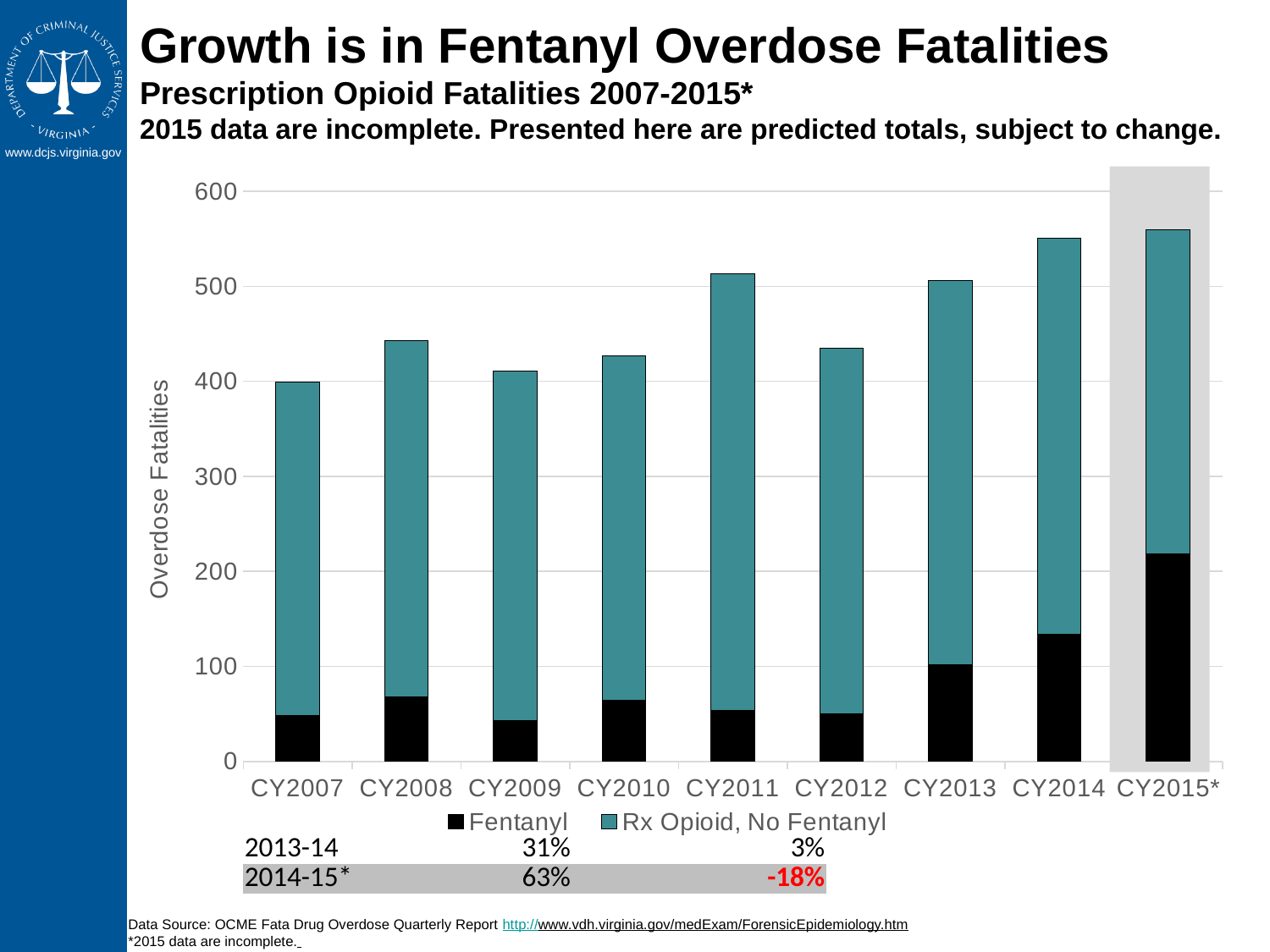
Is the Fentanyl value for CY2014 greater or less than 100? greater Which year has the highest Fentanyl value in the chart? CY2015* Which stacked bar is taller in total, CY2011 or CY2012? CY2011 How many series does the chart's legend list? 2 Is the total height of the stacked bar for CY2011 greater or less than 500? greater What are the two series named in the chart's legend? Fentanyl; Rx Opioid, No Fentanyl Is the Fentanyl value for CY2015* greater or less than 200? greater Does the Fentanyl value rise or fall from CY2012 to CY2015*? rise What kind of chart is shown on the slide? stacked bar chart How many years (categories) are shown on the x axis of the chart? 9